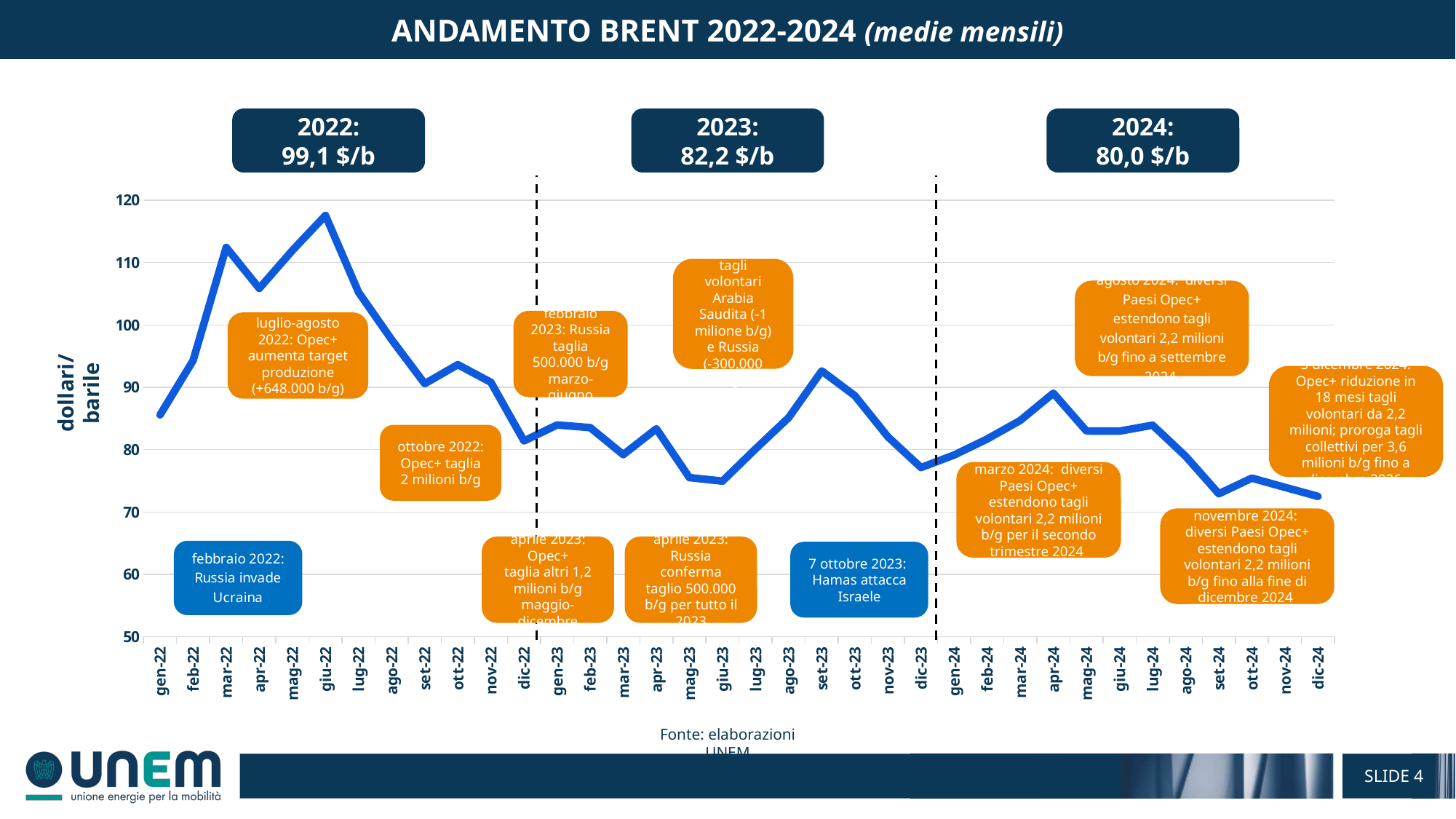
Is the value for giu-23 greater or less than 80? less In which month does the line reach its lowest value? dic-24 What annual average value is shown in the box for 2024? 80,0 $/b What kind of chart is shown on the slide? line chart What annual average value is shown in the box for 2022? 99,1 $/b What is the label of the vertical axis? dollari/barile How many monthly points are plotted on the x axis? 36 Which is larger, the value for mar-22 or the value for apr-22? mar-22 What is the title of the chart? ANDAMENTO BRENT 2022-2024 (medie mensili) What is the difference between the annual average shown for 2022 and the one shown for 2023? 16,9 $/b In which month does the line reach its highest value? giu-22 Is the value for giu-22 greater or less than 110? greater